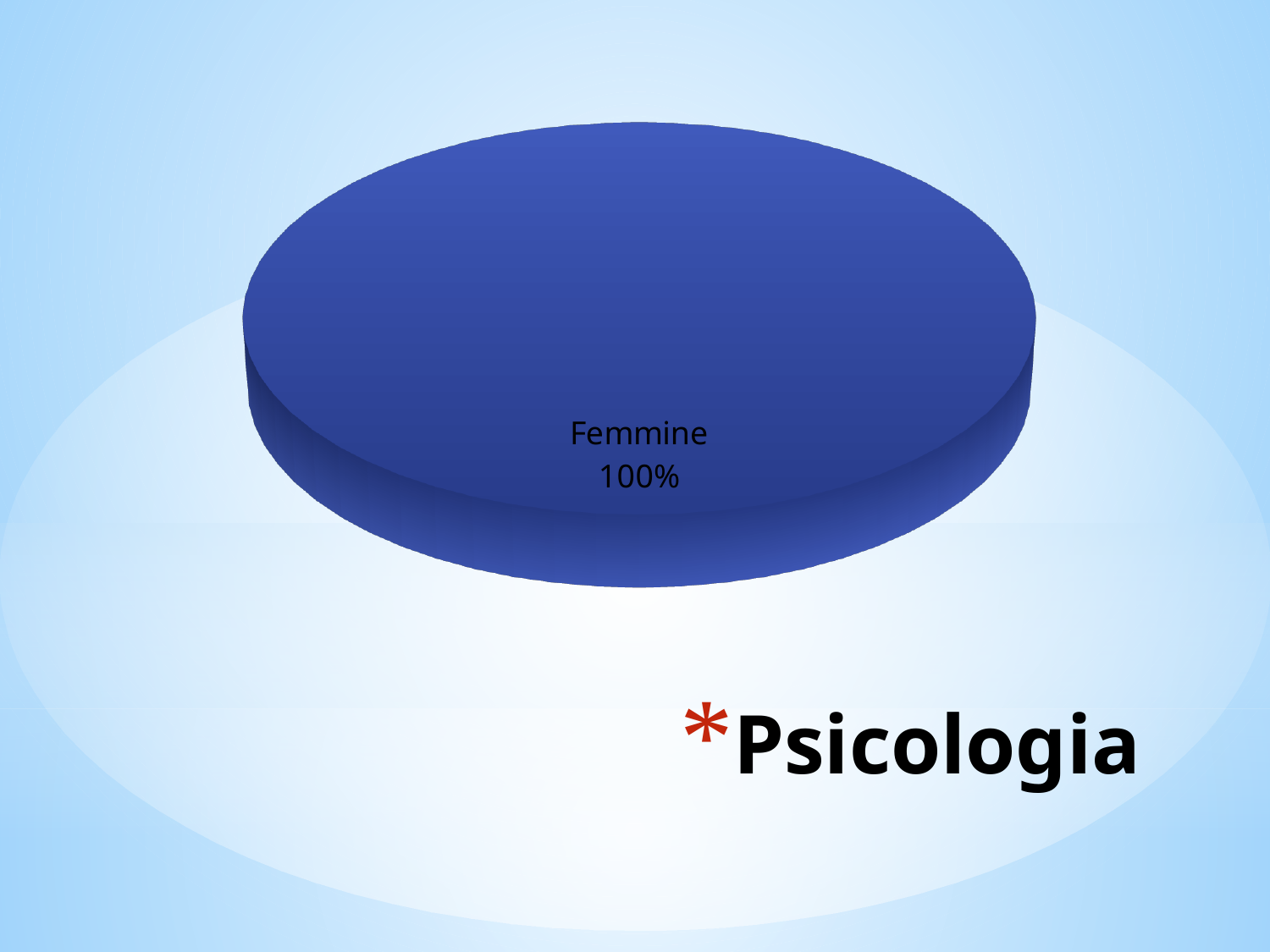
What kind of chart is shown on the slide? pie chart What text appears next to the red asterisk below the chart? Psicologia What is the label of the only slice in the pie chart? Femmine How many slices does the pie chart have? 1 What is the value printed for the Femmine slice? 100% Which category is the largest slice of the pie? Femmine What share of the pie does the Femmine slice represent? 100%